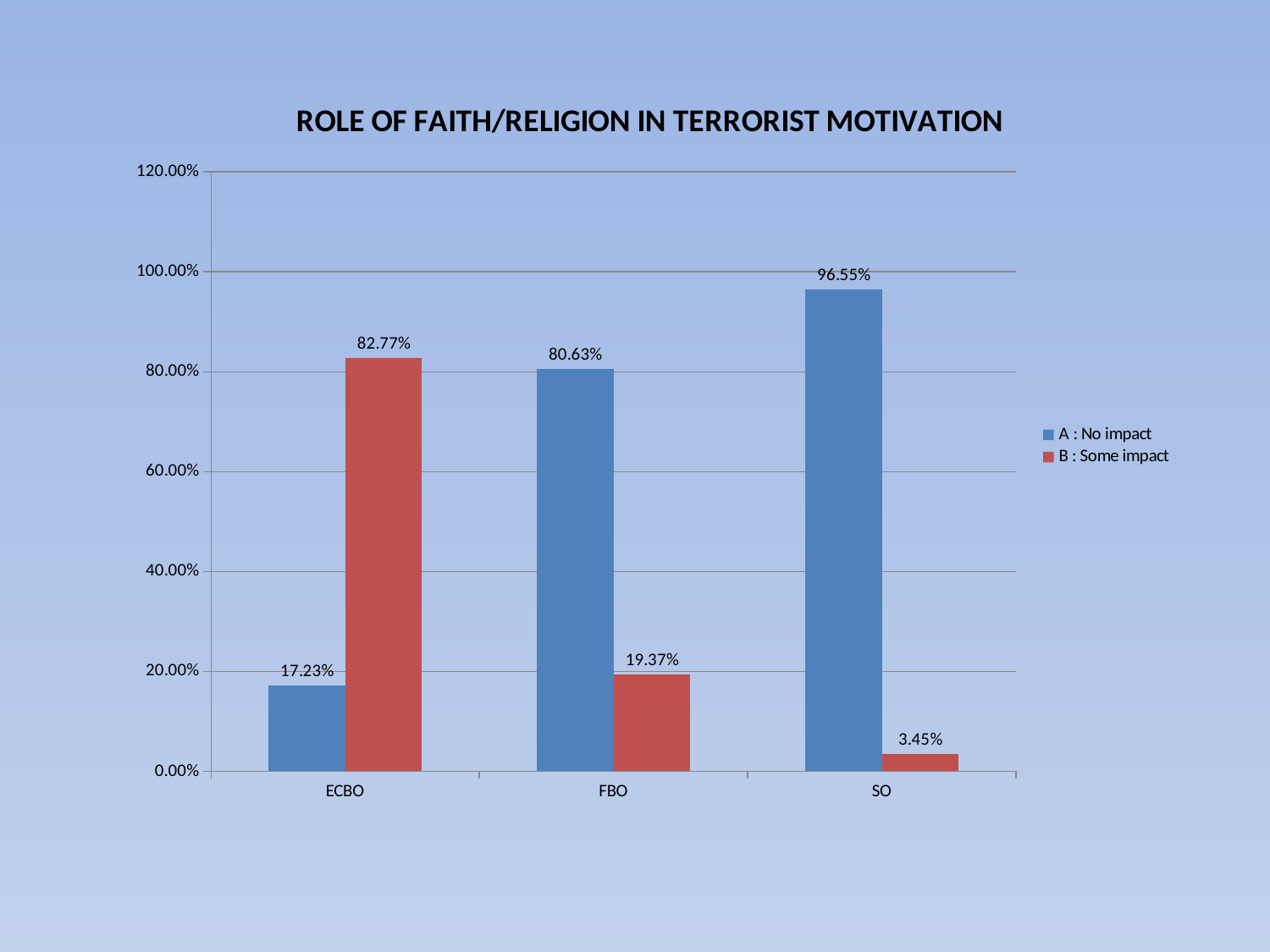
Which category has the lowest value for 'B : Some impact'? SO What kind of chart is shown on the slide? Bar chart What is the title of the chart? ROLE OF FAITH/RELIGION IN TERRORIST MOTIVATION What is the value for 'B : Some impact' for FBO? 19.37% Which category has the highest value for 'A : No impact'? SO What is the difference between 'B : Some impact' and 'A : No impact' for ECBO? 65.54% Which is larger for FBO: 'A : No impact' or 'B : Some impact'? A : No impact How many categories are shown on the x axis? 3 Is the value for 'B : Some impact' for ECBO greater or less than 80.00%? greater What is the value for 'A : No impact' for ECBO? 17.23% What is the value for 'A : No impact' for SO? 96.55% How many series does the legend list? 2